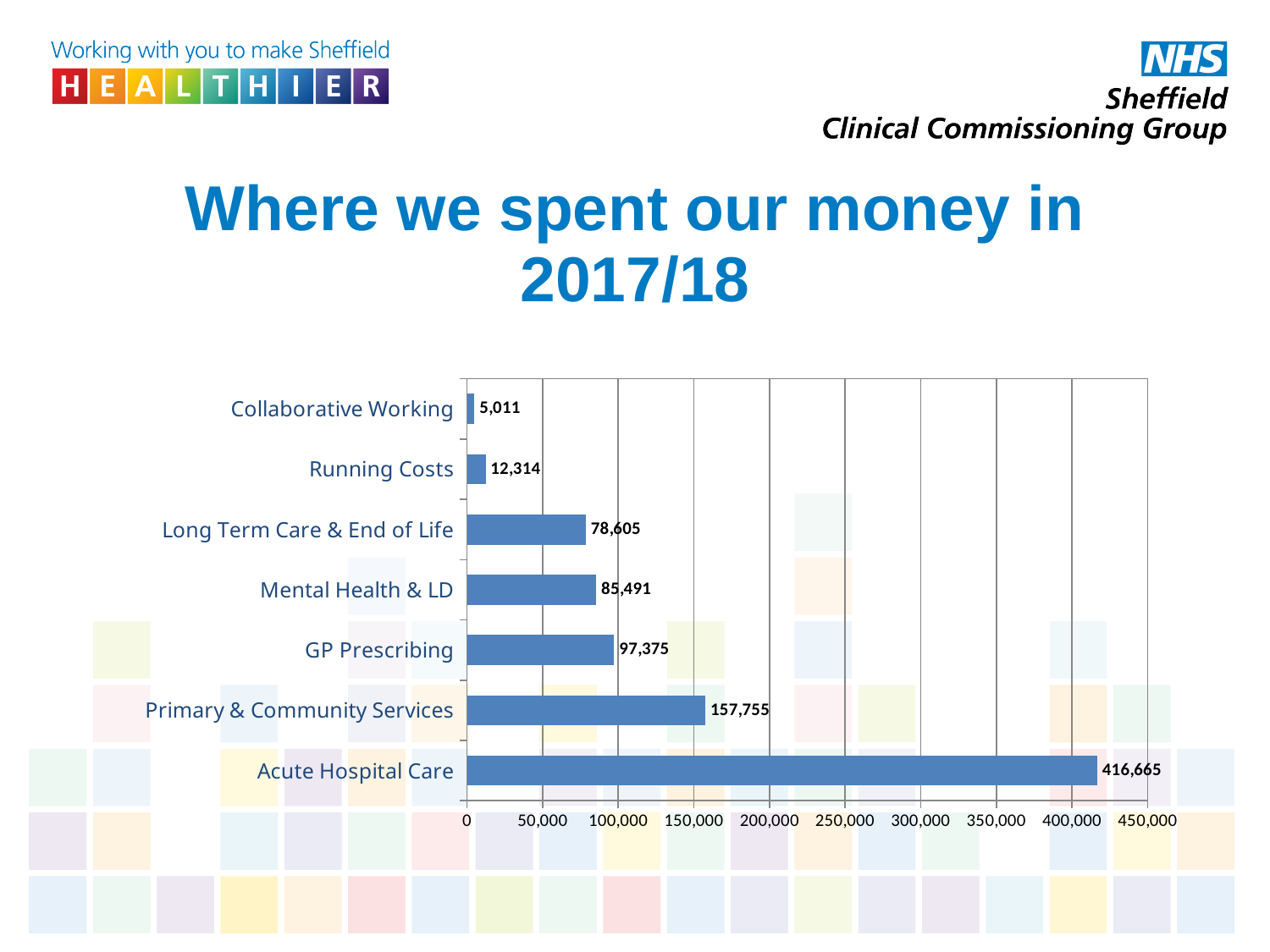
What is the difference between the values for GP Prescribing and Mental Health & LD? 11,884 Which is larger, the value for Mental Health & LD or the value for Long Term Care & End of Life? Mental Health & LD Which category has the highest value? Acute Hospital Care What is the value for GP Prescribing? 97,375 What is the difference between the values for Acute Hospital Care and Primary & Community Services? 258,910 What is the value for Long Term Care & End of Life? 78,605 What kind of chart is shown on the slide? Bar chart How many categories are shown in the chart? 7 What is the value for Acute Hospital Care? 416,665 Which category has the lowest value? Collaborative Working Is the value for Primary & Community Services greater or less than 150,000? greater What is the value for Running Costs? 12,314